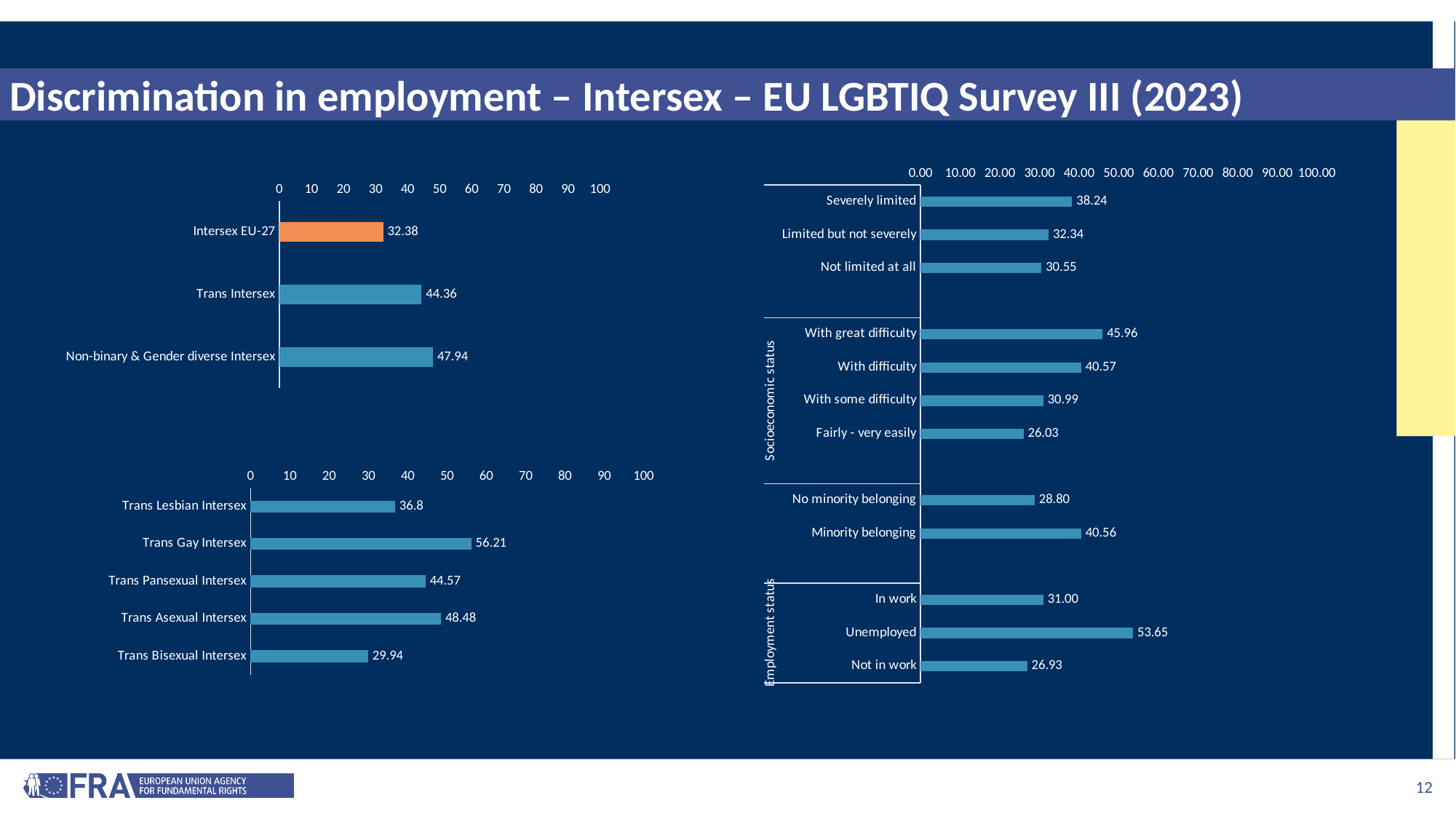
In the bottom-left chart, which is larger: Trans Asexual Intersex or Trans Pansexual Intersex? Trans Asexual Intersex In the right-hand chart, what is the value for Fairly - very easily? 26.03 In the bottom-left chart, what is the value for Trans Gay Intersex? 56.21 In the right-hand chart, which category has the highest value? Unemployed In the bottom-left chart, which category has the lowest value? Trans Bisexual Intersex In the top-left chart, what is the difference between Non-binary & Gender diverse Intersex and Intersex EU-27? 15.56 What type of chart is the top-left chart? Bar chart In the top-left chart, what is the value for Intersex EU-27? 32.38 In the right-hand chart, what is the difference between Minority belonging and No minority belonging? 11.76 In the right-hand chart, what is the value for Unemployed? 53.65 In the bottom-left chart, how many categories are shown? 5 In the top-left chart, which category has the highest value? Non-binary & Gender diverse Intersex